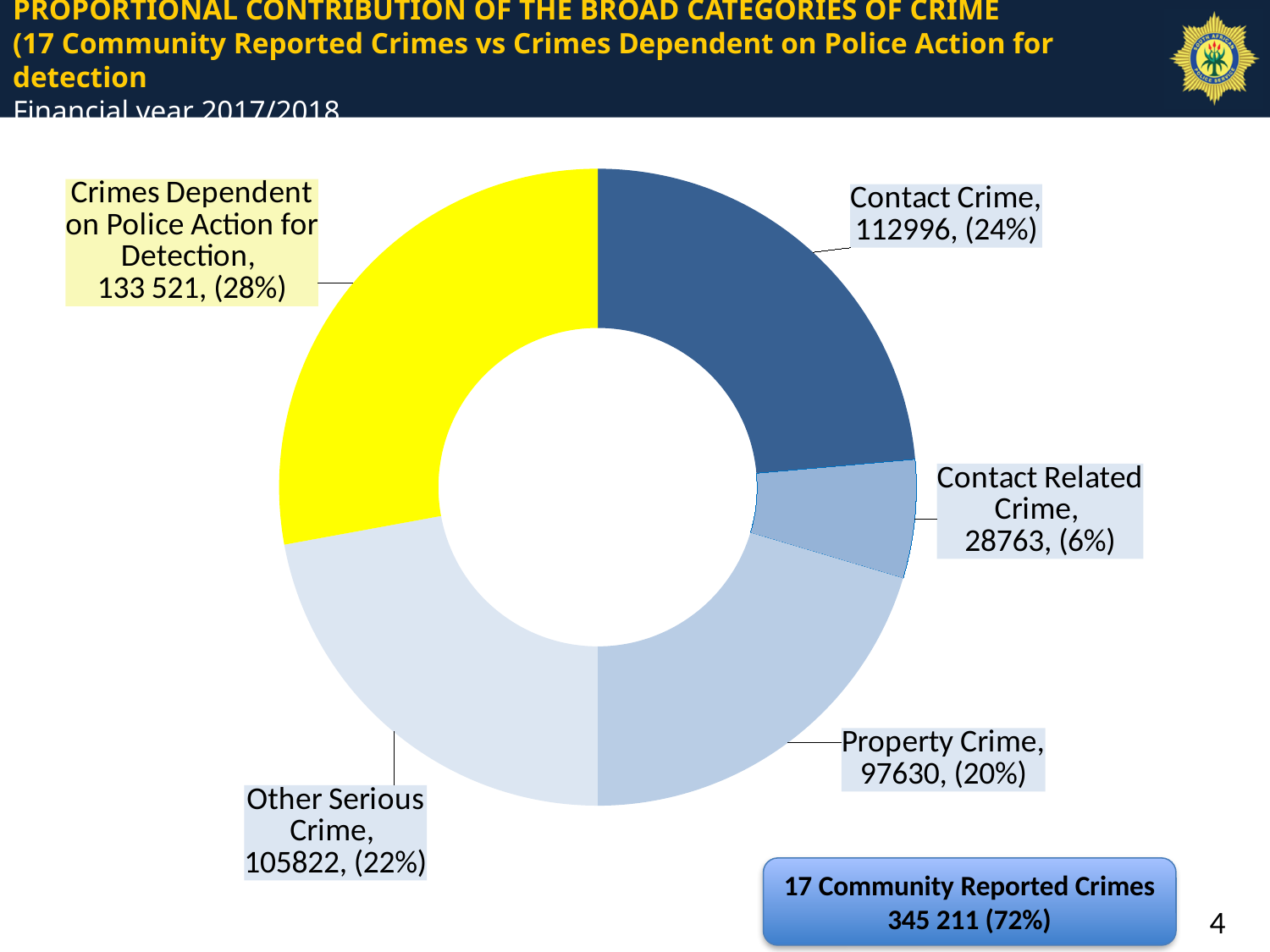
What is the value for Crimes Dependent on Police Action for Detection? 133 521 What is the value for Contact Crime? 112996 Which category has the smallest value? Contact Related Crime How many categories does the chart show? 5 What share of the chart does Other Serious Crime represent? 22% What kind of chart is shown on the slide? doughnut (pie) chart Which category has the largest value? Crimes Dependent on Police Action for Detection Which is larger, Other Serious Crime or Property Crime? Other Serious Crime What total is shown in the box for the 17 Community Reported Crimes? 345 211 (72%) What is the difference between the values for Contact Crime and Property Crime? 15366 What is the value for Contact Related Crime? 28763 What share of the chart does Property Crime represent? 20%